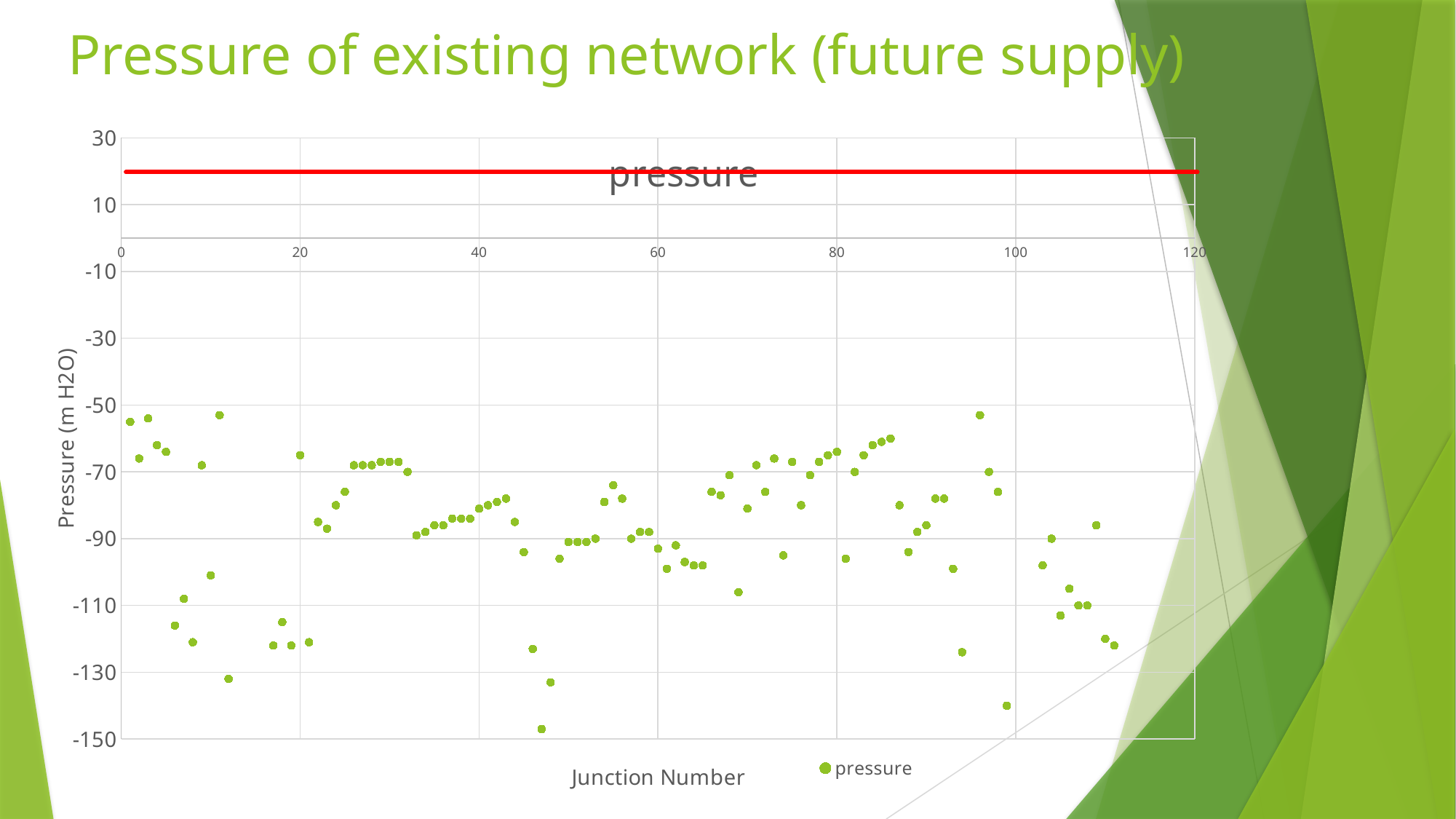
What kind of chart is shown on the slide? scatter chart Is the lowest plotted point between x-axis ticks 80 and 100 greater or less than -130? less How many series does the legend list? 1 Are any of the plotted pressure values greater than 0? No What is the title of the chart? pressure Is the lowest plotted pressure value greater or less than -140? less What is the minimum value shown on the y axis? -150 Between which two x-axis tick values does the lowest plotted pressure point fall? 40 and 60 What is the x-axis title of the chart? Junction Number What is the maximum value shown on the x axis? 120